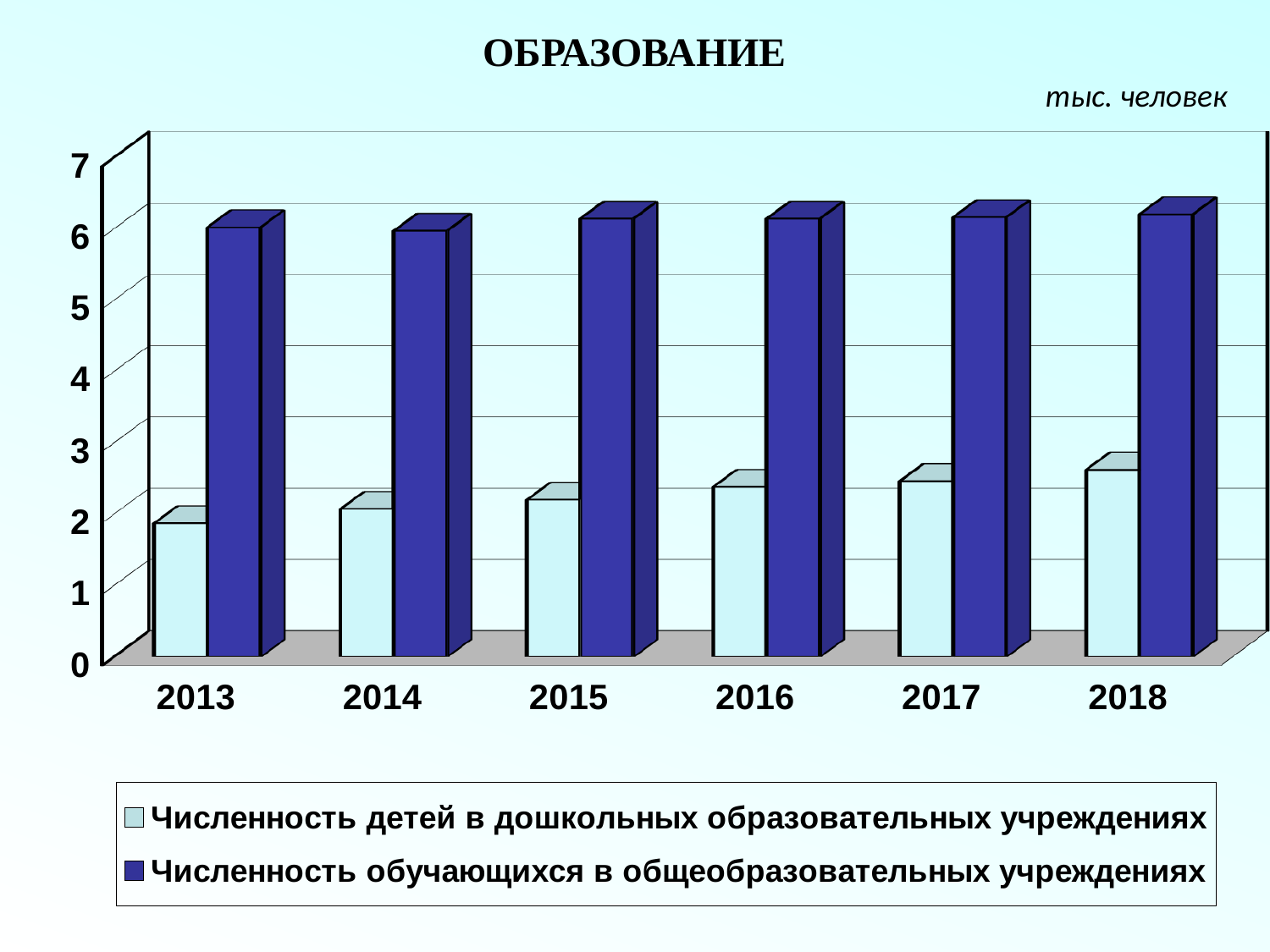
What unit is indicated for the values in the chart? тыс. человек Does the value for Численность детей в дошкольных образовательных учреждениях rise or fall from 2013 to 2018? rise In 2016, which series has the larger value: Численность детей в дошкольных образовательных учреждениях or Численность обучающихся в общеобразовательных учреждениях? Численность обучающихся в общеобразовательных учреждениях What kind of chart is shown on the slide? bar chart How many series does the legend list? 2 Is the value for Численность обучающихся в общеобразовательных учреждениях in 2013 greater or less than 5? greater Which year has the lowest value for Численность детей в дошкольных образовательных учреждениях? 2013 Is the value for Численность обучающихся в общеобразовательных учреждениях in 2018 greater or less than 7? less Is the value for Численность детей в дошкольных образовательных учреждениях in 2018 greater or less than 2? greater What is the title of the chart? ОБРАЗОВАНИЕ How many years are shown on the x axis of the chart? 6